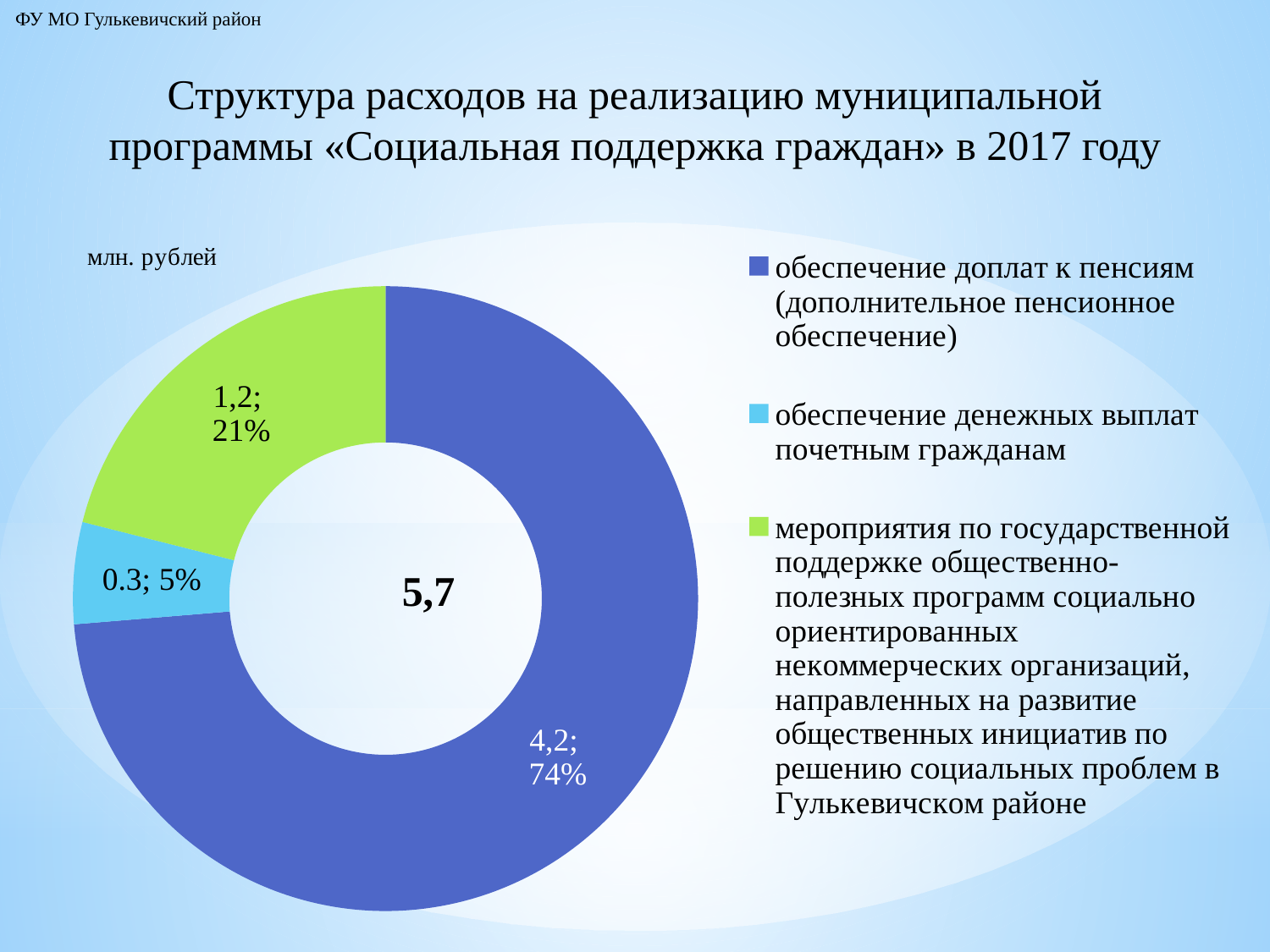
Which category has the smallest slice? обеспечение денежных выплат почетным гражданам What share of the chart does обеспечение денежных выплат почетным гражданам represent? 5% What value is shown for обеспечение денежных выплат почетным гражданам? 0.3 What value is shown for обеспечение доплат к пенсиям (дополнительное пенсионное обеспечение)? 4,2 What share of the chart does обеспечение доплат к пенсиям (дополнительное пенсионное обеспечение) represent? 74% What is the difference in percentage points between the share for обеспечение доплат к пенсиям and the share for мероприятия по государственной поддержке общественно-полезных программ? 53% How many categories does the chart show? 3 Which category has the largest slice? обеспечение доплат к пенсиям (дополнительное пенсионное обеспечение) What kind of chart is shown on the slide? doughnut chart What value is shown for мероприятия по государственной поддержке общественно-полезных программ социально ориентированных некоммерческих организаций? 1,2 What total value is shown in the centre of the chart? 5,7 What share of the chart does мероприятия по государственной поддержке общественно-полезных программ represent? 21%